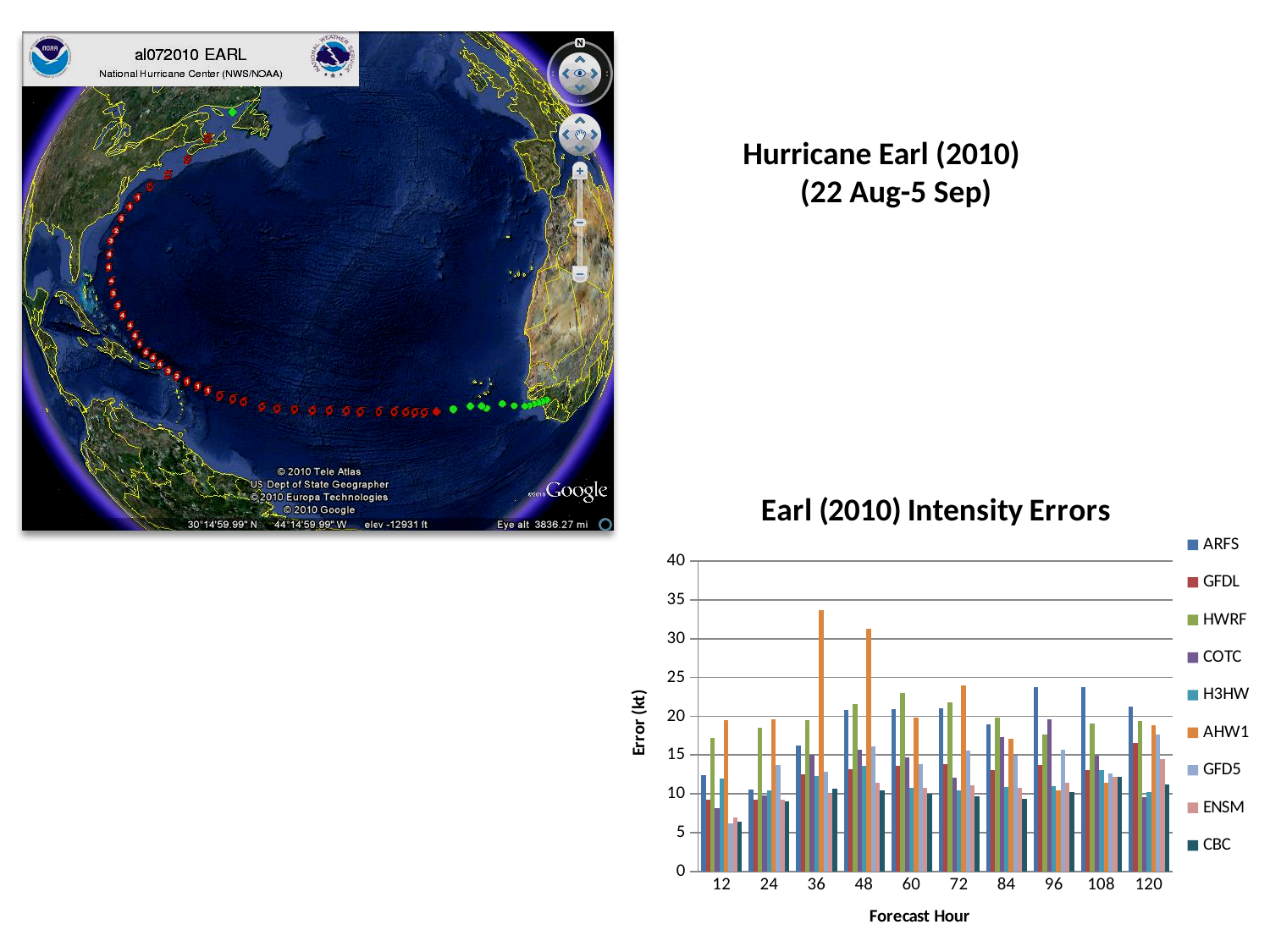
How many series does the legend of the "Earl (2010) Intensity Errors" chart list? 9 In the "Earl (2010) Intensity Errors" chart, is the HWRF value at forecast hour 60 greater or less than 20? greater What kind of chart is "Earl (2010) Intensity Errors"? bar chart In the "Earl (2010) Intensity Errors" chart, is the AHW1 value at forecast hour 36 greater or less than 30? greater In the "Earl (2010) Intensity Errors" chart, is the CBC value at forecast hour 12 greater or less than 10? less In the "Earl (2010) Intensity Errors" chart, which series has the tallest bar at forecast hour 12? AHW1 What is the x-axis title of the "Earl (2010) Intensity Errors" chart? Forecast Hour In the "Earl (2010) Intensity Errors" chart, which series has the tallest bar at forecast hour 96? ARFS How many forecast hours are shown on the x axis of the "Earl (2010) Intensity Errors" chart? 10 In the "Earl (2010) Intensity Errors" chart, which series has the tallest bar at forecast hour 36? AHW1 What is the y-axis title of the "Earl (2010) Intensity Errors" chart? Error (kt)